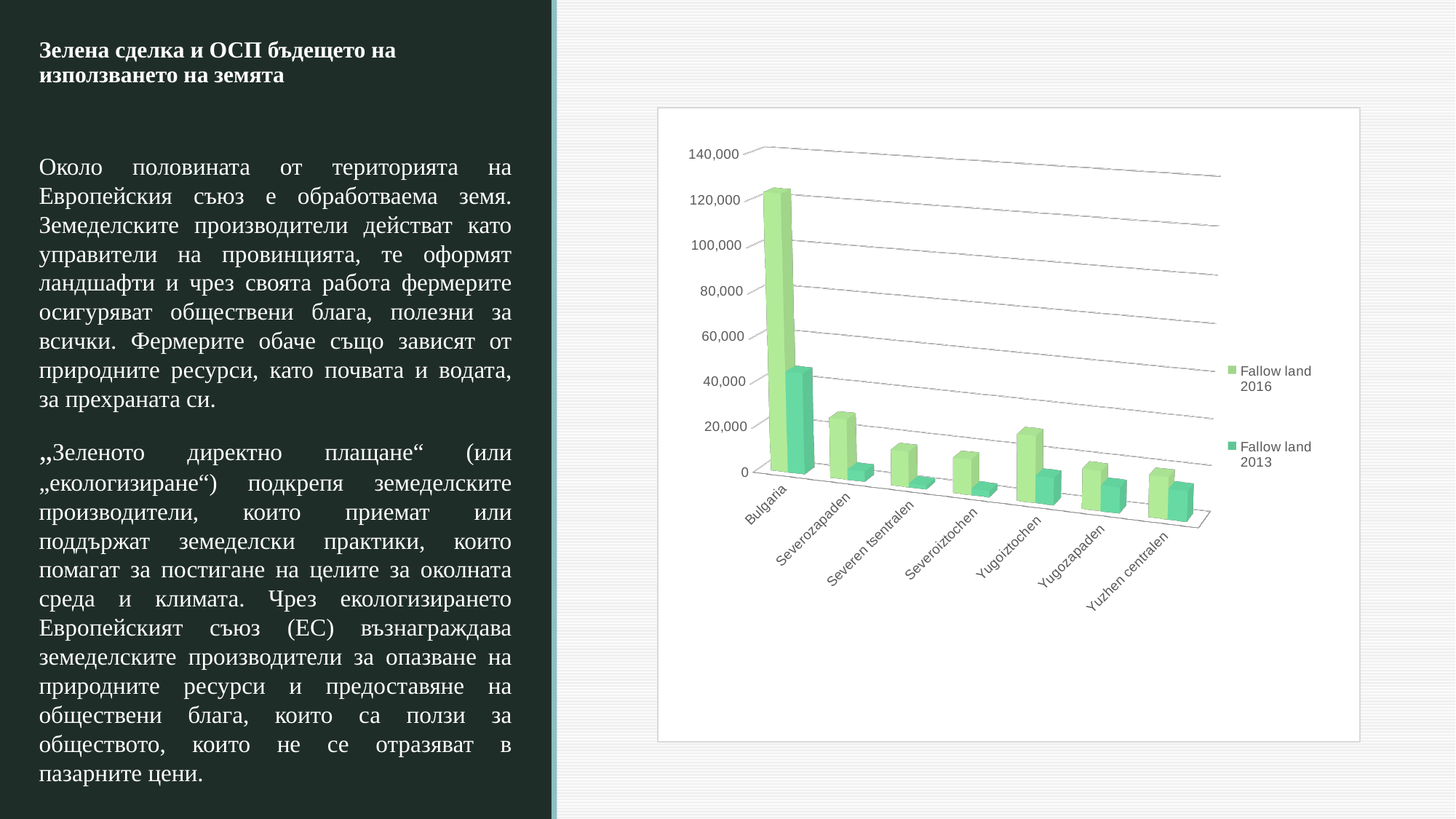
Is the Fallow land 2016 value for Bulgaria greater or less than 100,000? greater Is the Fallow land 2013 value for Bulgaria greater or less than 20,000? greater For Bulgaria, which is larger: Fallow land 2016 or Fallow land 2013? Fallow land 2016 Which is larger for Fallow land 2016: Severozapaden or Severen tsentralen? Severozapaden Which category has the highest value for Fallow land 2016? Bulgaria Which is larger for Fallow land 2016: Yugoiztochen or Severoiztochen? Yugoiztochen How many series does the chart's legend list? 2 Is the Fallow land 2016 value for Severozapaden greater or less than 40,000? less Which category has the highest value for Fallow land 2013? Bulgaria What are the two entries listed in the chart's legend? Fallow land 2016 and Fallow land 2013 How many categories are shown on the x axis of the chart? 7 What kind of chart is shown on the slide? bar chart